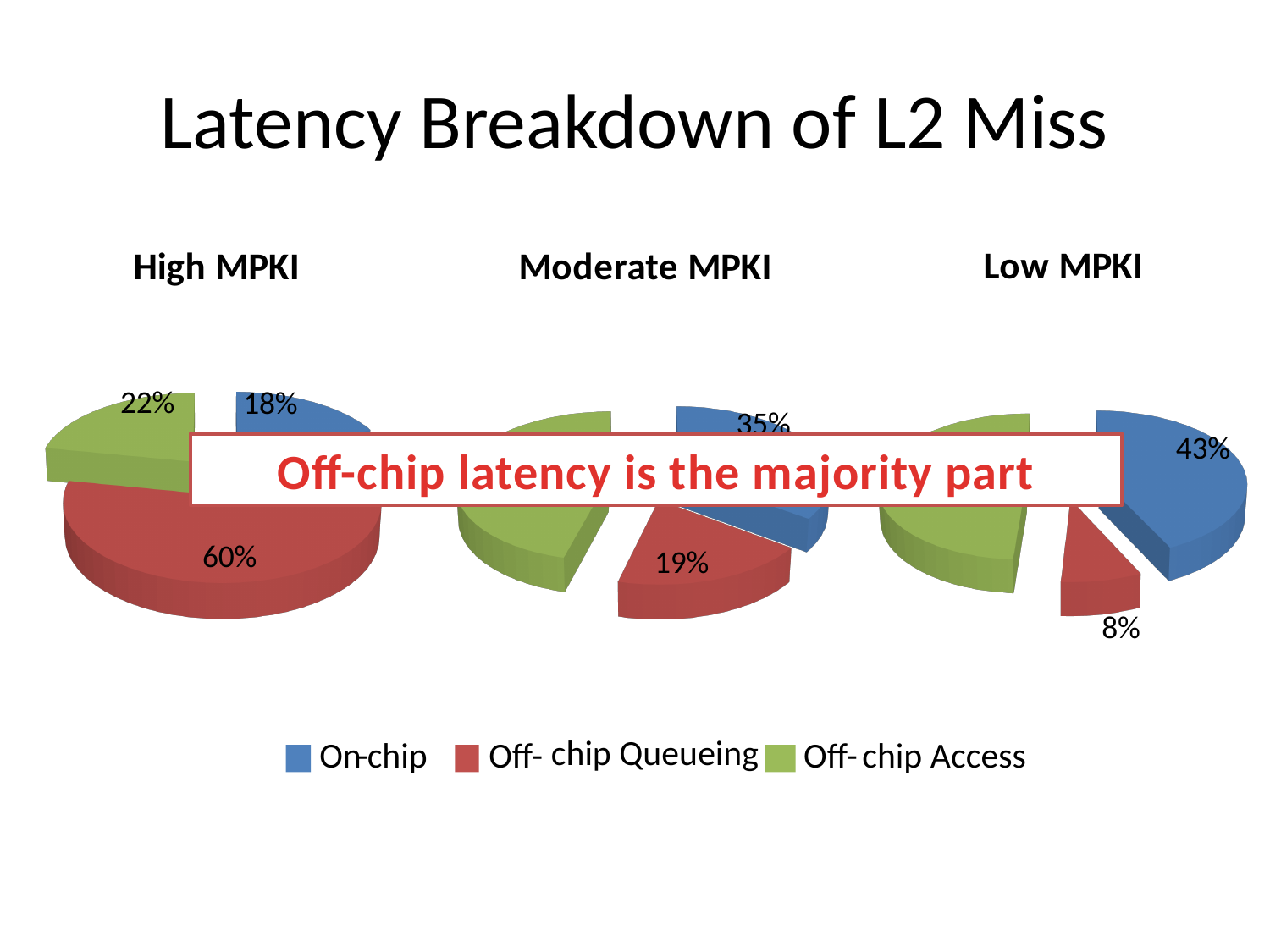
In the Moderate MPKI pie chart, which is larger, On-chip or Off-chip Queueing? On-chip In the High MPKI pie chart, which slice is the largest? Off-chip Queueing In the High MPKI pie chart, what share is Off-chip Access? 22% What kind of chart is used for the High MPKI, Moderate MPKI and Low MPKI breakdowns? Pie chart In the High MPKI pie chart, what share is On-chip? 18% In the Low MPKI pie chart, what share is Off-chip Queueing? 8% In the Moderate MPKI pie chart, what share is Off-chip Queueing? 19% In the Low MPKI pie chart, which slice is the smallest? Off-chip Queueing In the Low MPKI pie chart, what share is On-chip? 43% In the High MPKI pie chart, what share is Off-chip Queueing? 60% In the High MPKI pie chart, how many percentage points larger is Off-chip Queueing than On-chip? 42 percentage points How many entries does the shared legend list for the pie charts? 3